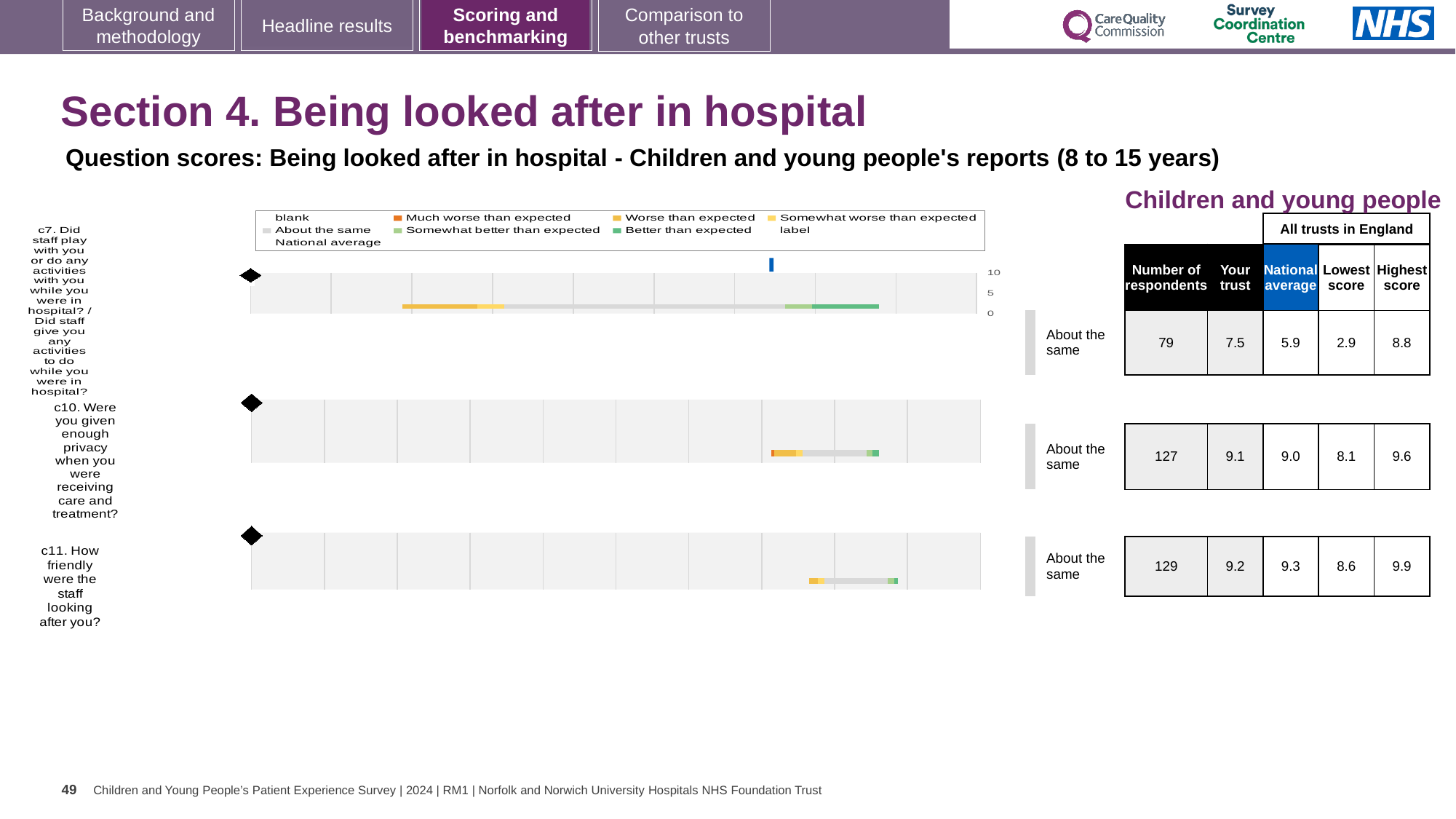
What benchmark category is shown for all three questions on the slide? About the same What is the highest score among all trusts in England for question c10? 9.6 What is the difference between the highest score and the lowest score for question c7? 5.9 What is the 'Your trust' score for question c10 (Were you given enough privacy when you were receiving care and treatment?)? 9.1 Which question has the lowest 'Your trust' score? c7. Did staff play with you or do any activities with you while you were in hospital? Which question has the highest 'Your trust' score? c11. How friendly were the staff looking after you? What is the lowest score among all trusts in England for question c7? 2.9 How many respondents answered question c7 (Did staff play with you or do any activities with you while you were in hospital?)? 79 How many questions (categories) are plotted in the chart? 3 What is the national average score for question c11 (How friendly were the staff looking after you?)? 9.3 What kind of chart is used to show the question scores? bar chart For question c7, which is larger: the 'Your trust' score or the national average? Your trust